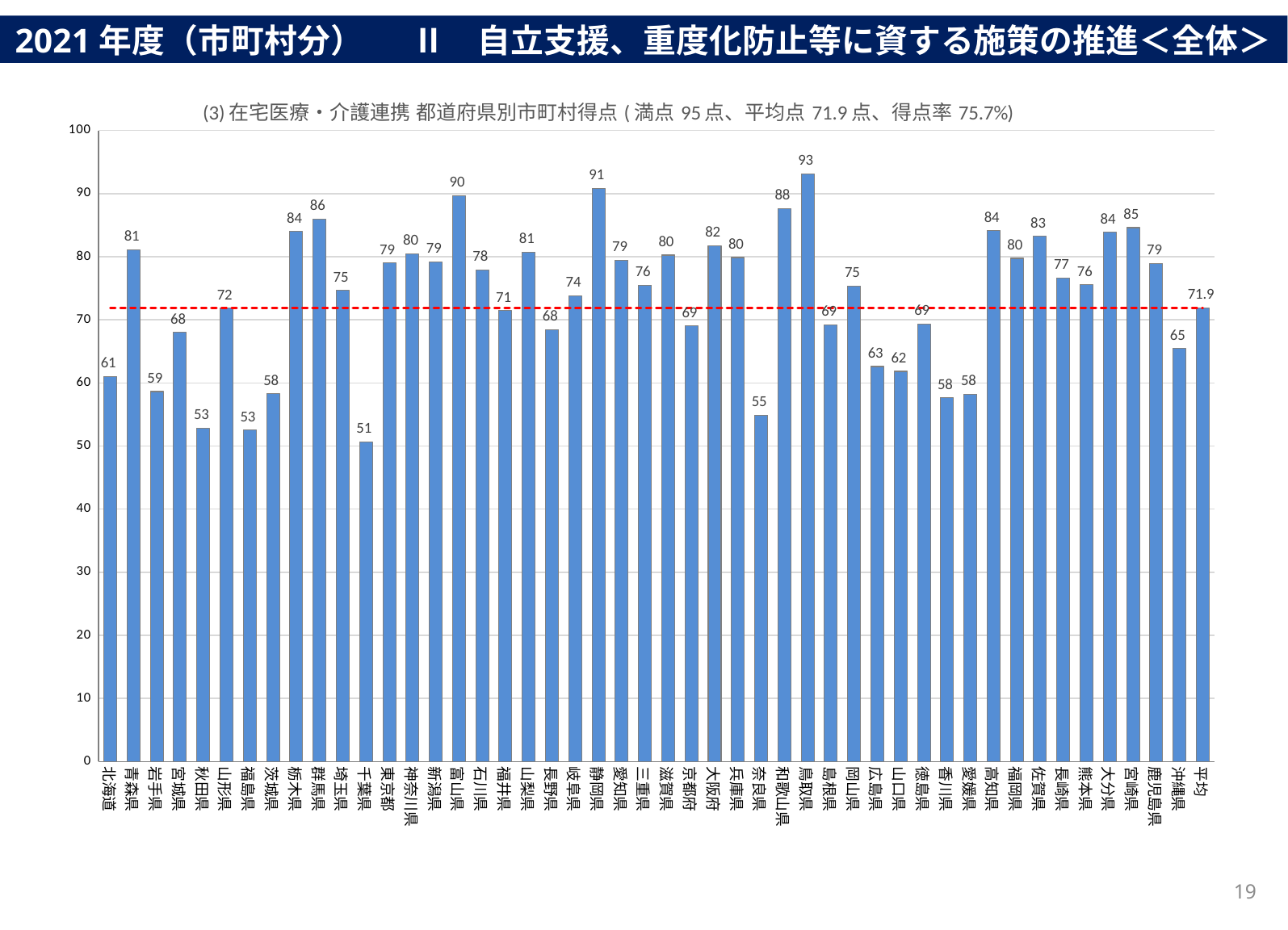
Which category has the lowest value? 千葉県 What is the value shown for 平均? 71.9 What is the difference between the values for 静岡県 and 奈良県? 36 What kind of chart is shown on the slide? bar chart What does the red dashed horizontal line across the chart represent? the average (平均点 71.9) What is the value for 千葉県? 51 Is the value for 沖縄県 greater or less than 70? less How many bars are plotted in the chart, including 平均? 48 What is the value for 鳥取県? 93 Which category has the highest value? 鳥取県 Which is larger, the value for 富山県 or the value for 和歌山県? 富山県 What is the value for 群馬県? 86